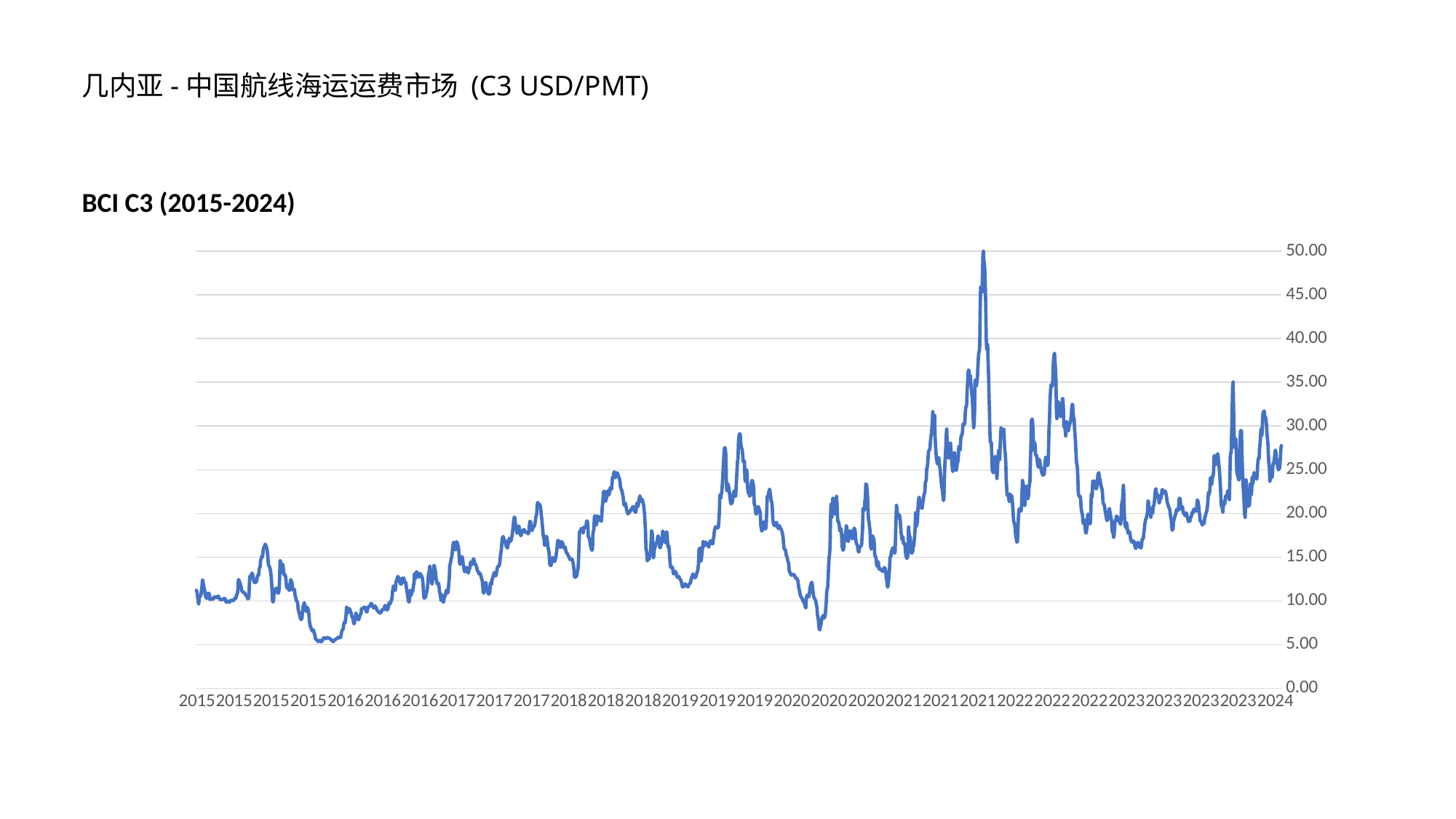
Overall, does the line rise or fall from 2015 to 2024? rise Which is higher: the peak of the line in 2019 or the peak in 2018? 2019 Is the highest peak of the line in 2021 greater or less than 45? greater Is the value at the start of 2015 greater or less than 15? less What is the title of the chart? BCI C3 (2015-2024) Is the lowest point of the line, reached around 2015-2016, greater or less than 10? less What kind of chart is shown on the slide? line chart Which is higher: the peak of the line in 2021 or the peak in 2022? 2021 What is the highest value shown on the vertical axis? 50.00 In which year does the line reach its highest peak? 2021